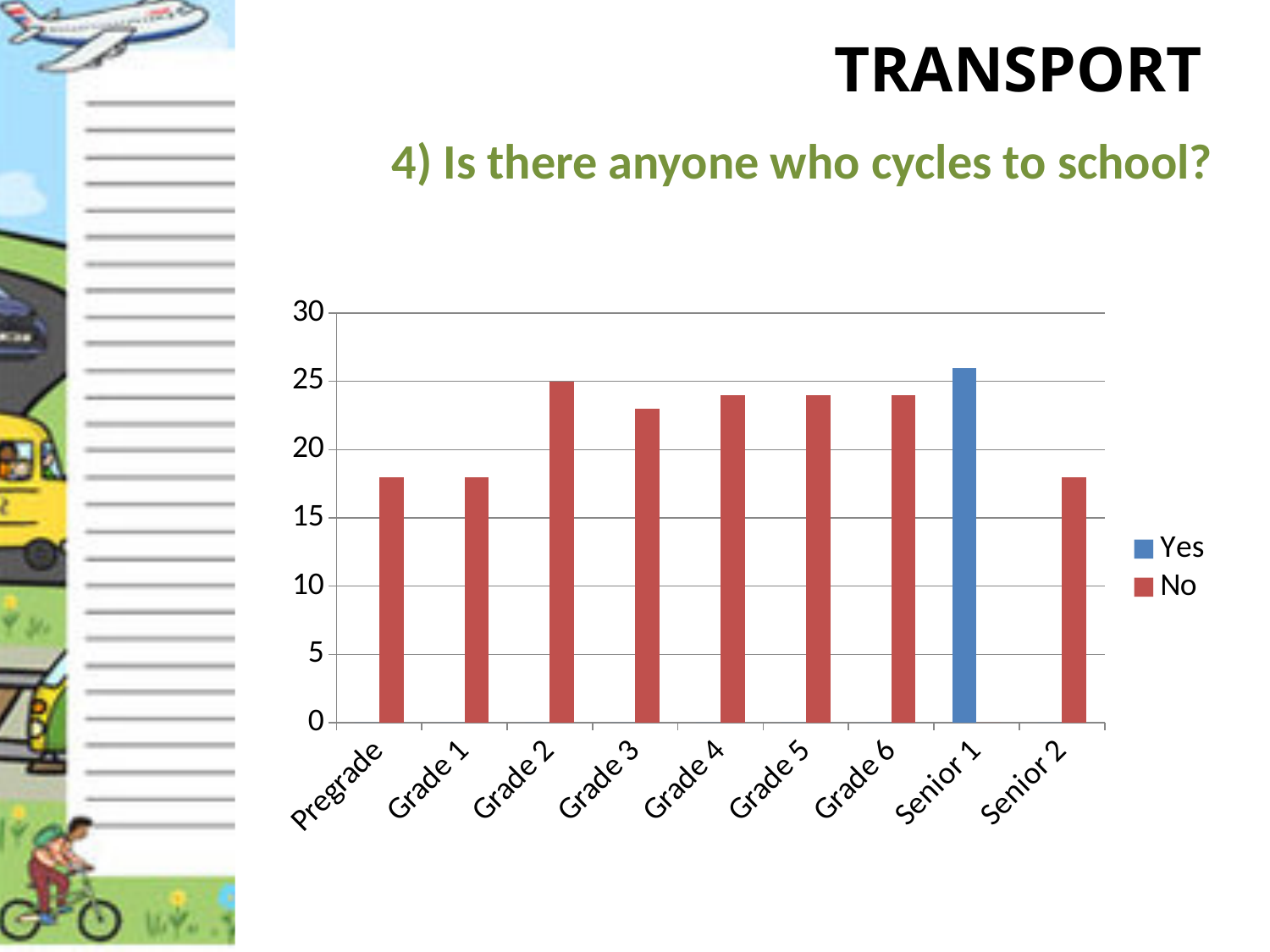
Is the value for Senior 1 greater or less than 25? greater Which category is the only one plotted in the 'Yes' series? Senior 1 How many categories are shown on the x axis of the chart? 9 How many series does the chart's legend list? 2 Which category has the highest bar in the chart? Senior 1 Is the value for Grade 3 greater or less than 20? greater Is the value for Pregrade greater or less than 20? less What kind of chart is shown on the slide? bar chart What are the two entries in the chart's legend? Yes, No Which is larger, the value for Grade 1 or the value for Grade 2? Grade 2 What is the value for Grade 2? 25